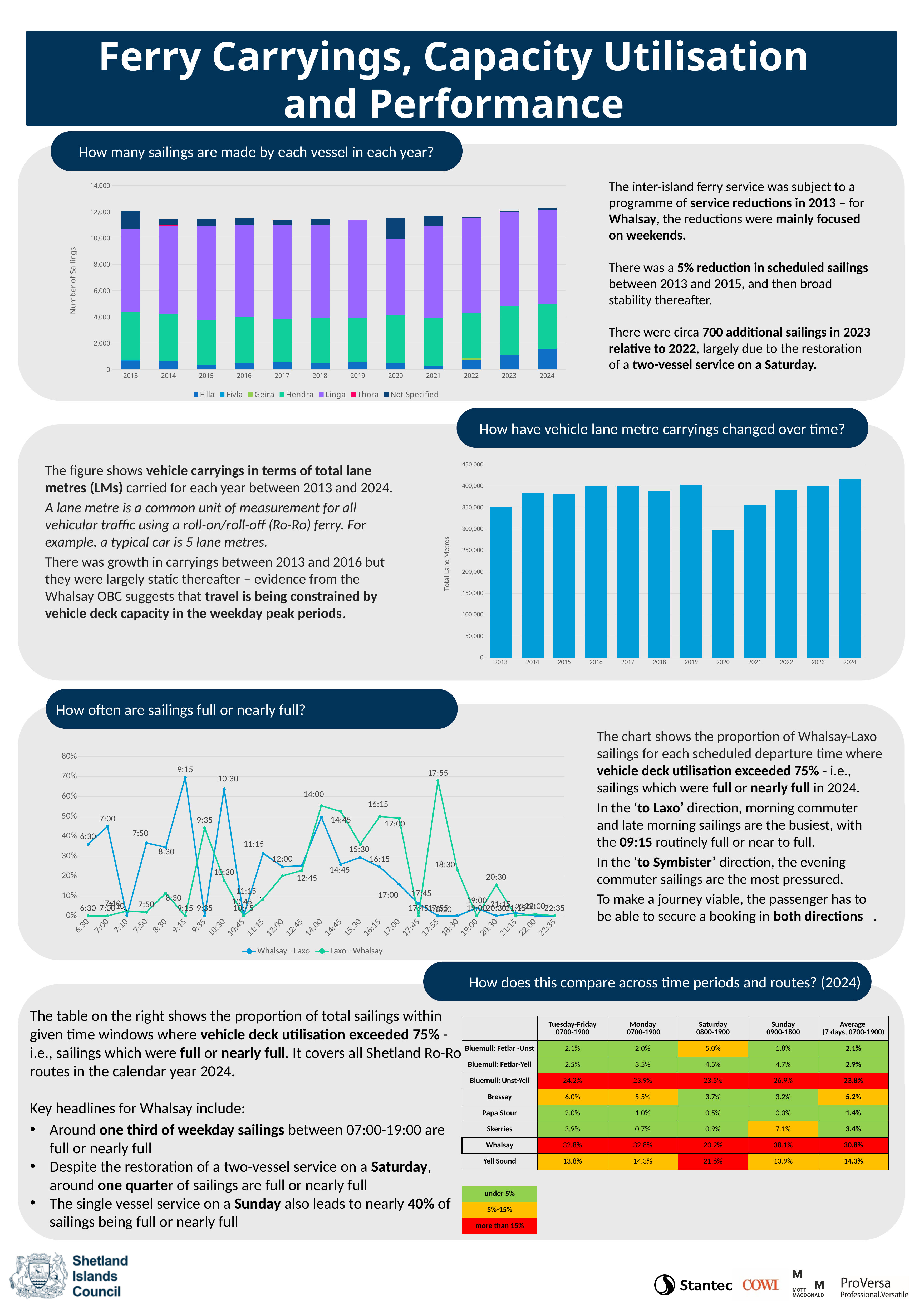
In the chart 'How have vehicle lane metre carryings changed over time?', is the value for 2024 greater or less than 400,000? greater In the chart 'How have vehicle lane metre carryings changed over time?', is the value for 2020 greater or less than 350,000? less In the chart 'How many sailings are made by each vessel in each year?', is the total number of sailings for 2020 greater or less than 10,000? greater In the chart 'How have vehicle lane metre carryings changed over time?', which year has the highest total lane metres? 2024 In the chart 'How often are sailings full or nearly full?', at which departure time does the Whalsay - Laxo series reach its highest value? 9:15 In the chart 'How many sailings are made by each vessel in each year?', how many series does the legend list? 7 In the chart 'How have vehicle lane metre carryings changed over time?', do the values rise or fall from 2013 to 2016? rise What kind of chart is used under 'How many sailings are made by each vessel in each year?' Stacked bar chart In the chart 'How often are sailings full or nearly full?', which two series does the legend list? Whalsay - Laxo and Laxo - Whalsay In the chart 'How have vehicle lane metre carryings changed over time?', which year has the lowest total lane metres? 2020 In the chart 'How many sailings are made by each vessel in each year?', how many years are shown on the x axis? 12 What kind of chart is used under 'How often are sailings full or nearly full?' Line chart